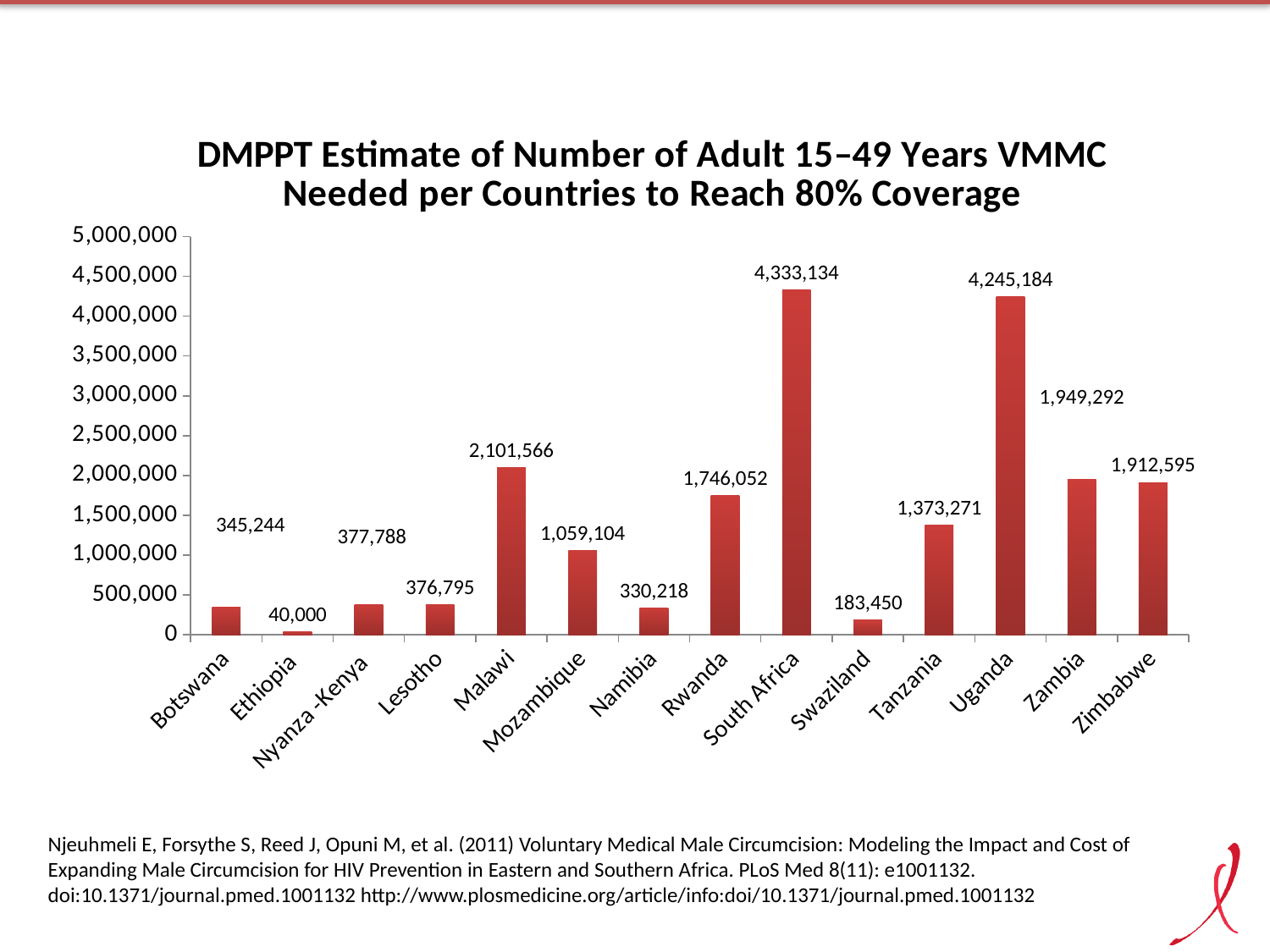
What is the estimated number of VMMC needed for Malawi? 2,101,566 What is the difference between the values for Malawi and Rwanda? 355,514 What type of chart is shown on the slide? bar chart Which country has the highest estimated number of VMMC needed? South Africa What is the estimated number of VMMC needed for Uganda? 4,245,184 Which has a larger value, Zambia or Tanzania? Zambia What is the difference between the values for South Africa and Uganda? 87,950 Is the value for Tanzania greater or less than 1,500,000? less How many countries are shown on the x axis of the chart? 14 Which country has the lowest estimated number of VMMC needed? Ethiopia What is the estimated number of VMMC needed for Swaziland? 183,450 What is the title of the chart? DMPPT Estimate of Number of Adult 15–49 Years VMMC Needed per Countries to Reach 80% Coverage